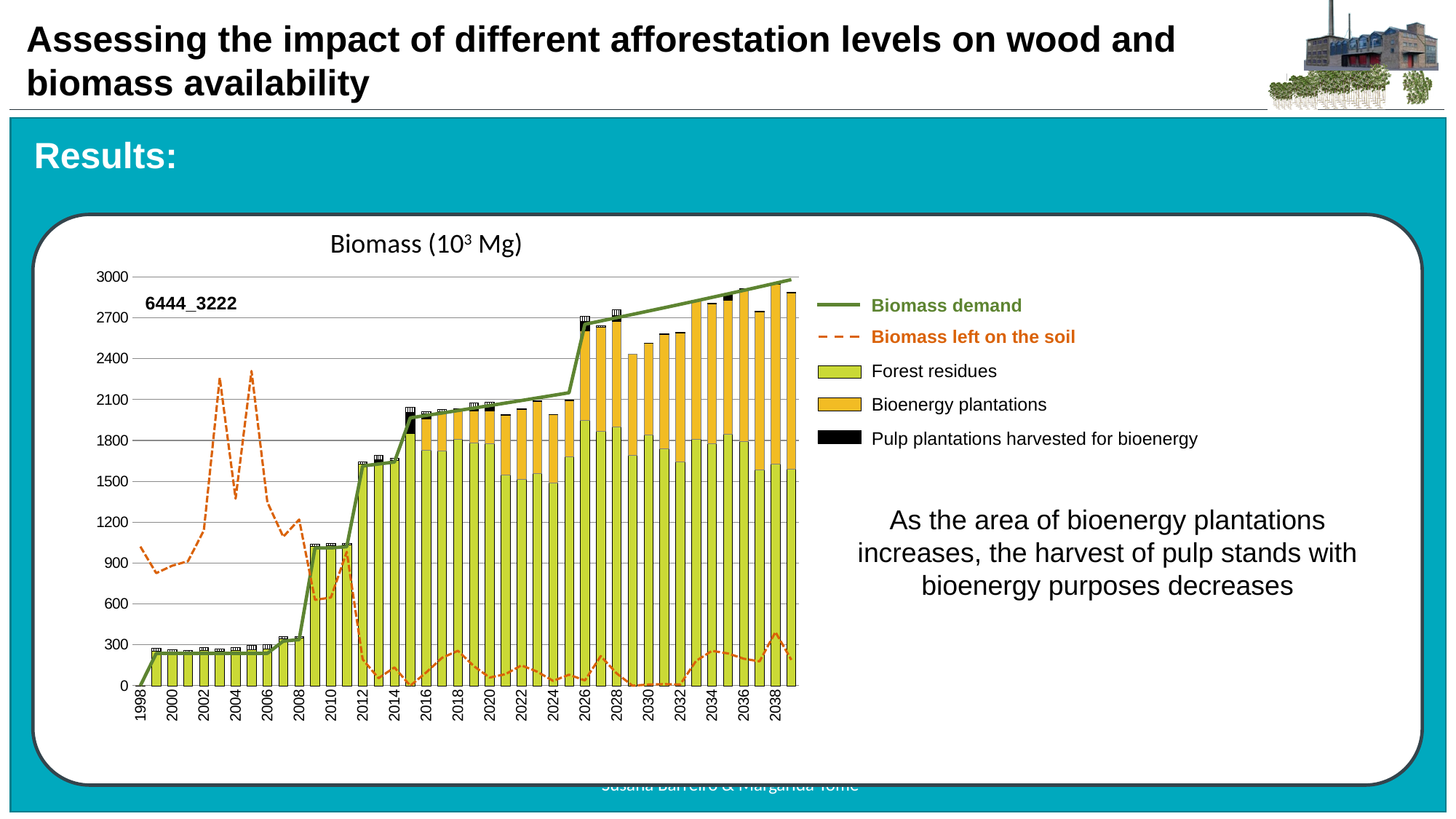
Is the Biomass left on the soil value for 2030 greater or less than 300? less Is the Biomass left on the soil value for 2005 greater or less than 2100? greater Is the Biomass demand value for 2038 greater or less than 2700? greater How many series does the chart legend list? 5 What kind of chart is shown on the slide? Stacked bar chart with line series Does the Biomass demand line rise or fall from 1998 to 2039? Rises What is the title of the chart? Biomass (10³ Mg) Which legend entry is drawn as a dashed orange line? Biomass left on the soil